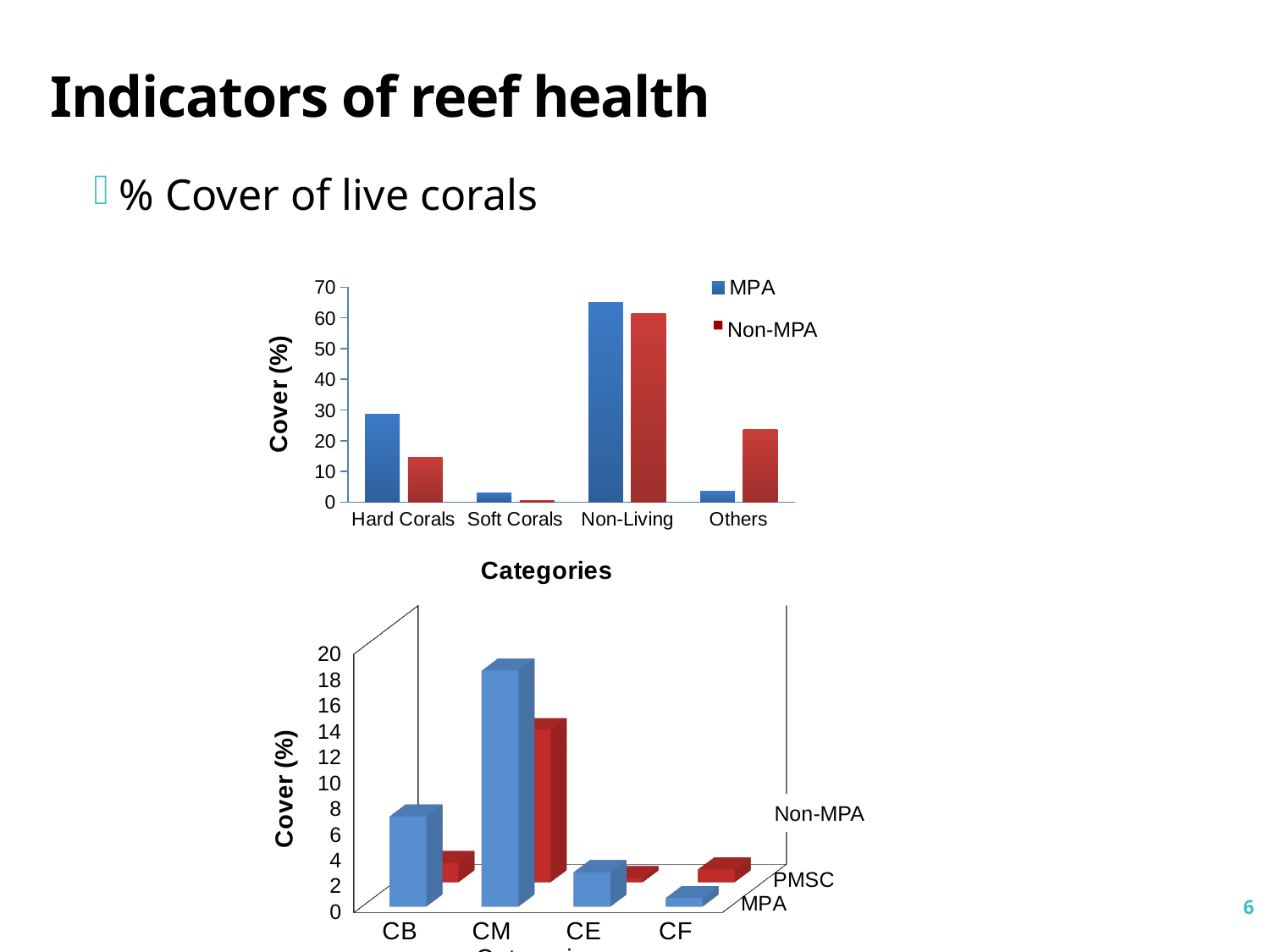
What kind of chart is the top chart on the slide? bar chart What is the y-axis title of the top chart? Cover (%) In the top chart, which category has the highest MPA value? Non-Living In the top chart, how many categories are shown on the x axis? 4 In the top chart, how many series does the legend list? 2 In the bottom chart, is the MPA value for CB greater or less than 10? less In the top chart, is the MPA value for Hard Corals greater or less than 20? greater In the bottom chart, which category has the highest MPA value? CM In the top chart, which category has the lowest Non-MPA value? Soft Corals In the top chart, for Hard Corals, which series has the larger value, MPA or Non-MPA? MPA In the top chart, is the Non-MPA value for Others greater or less than 30? less In the top chart, for Others, which series has the larger value, MPA or Non-MPA? Non-MPA